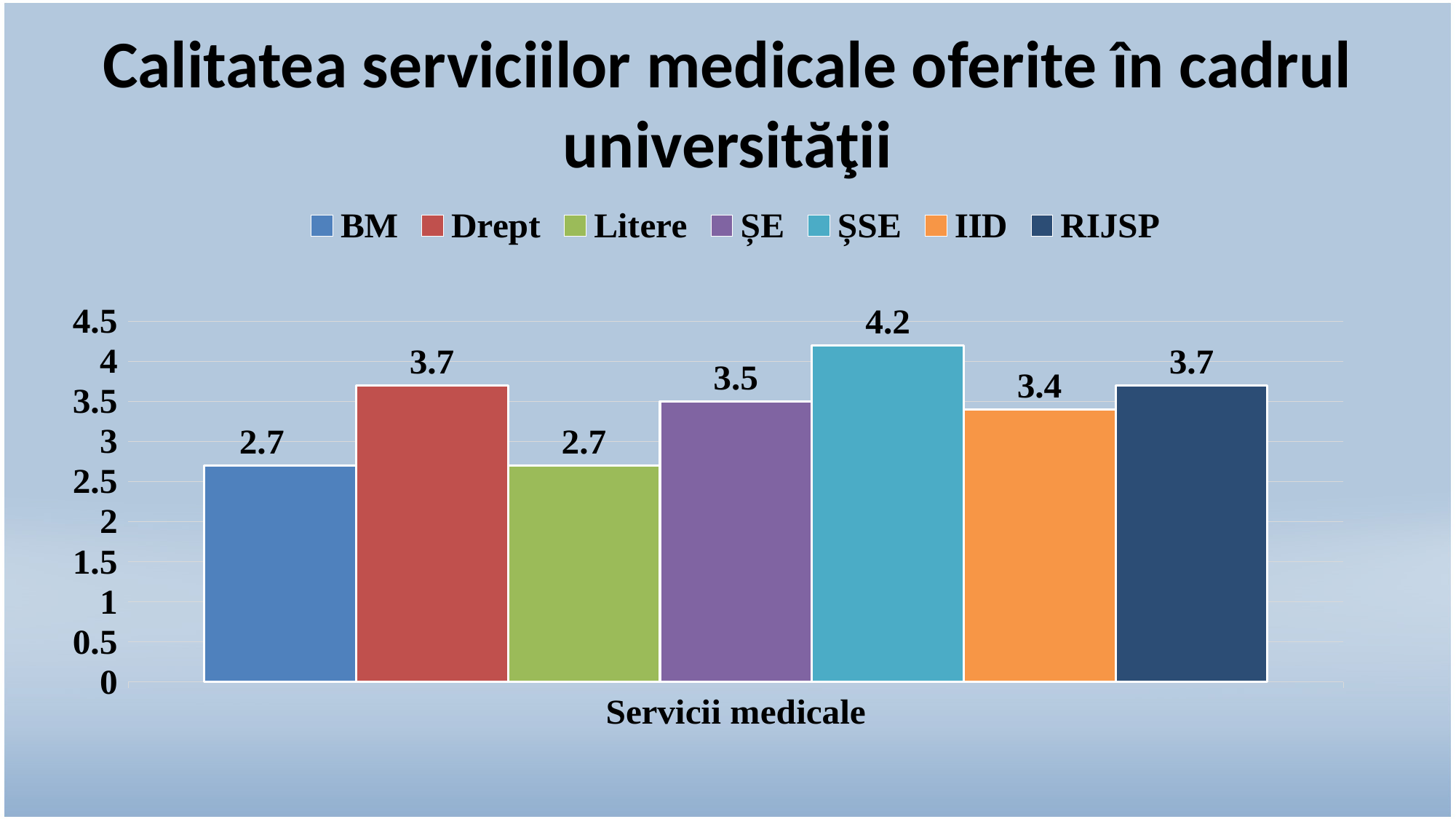
Which series share the lowest value of 2.7? BM and Litere What is the value for ȘE? 3.5 What is the value for IID? 3.4 Which series has the highest value? ȘSE What is the label on the x axis of the chart? Servicii medicale What is the difference between the values for ȘSE and BM? 1.5 What is the difference between the values for Drept and IID? 0.3 How many series does the legend list? 7 Is the value for RIJSP greater or less than 3? greater What kind of chart is shown on the slide? bar chart What is the value for ȘSE? 4.2 Which is larger, the value for Drept or the value for ȘE? Drept